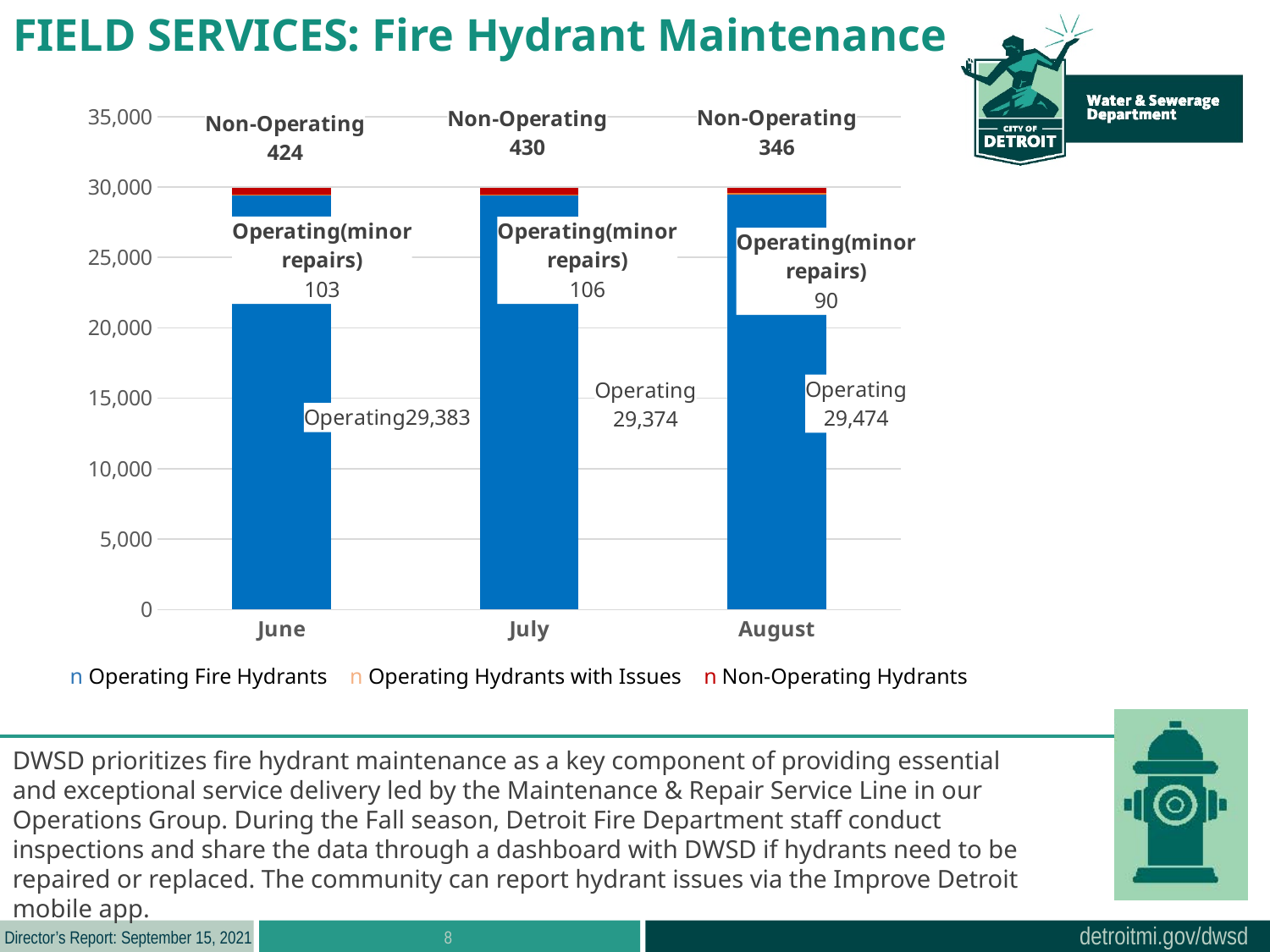
How many series does the chart legend list? 3 Which is larger, the Operating hydrant count in June or in August? August What is the number of Operating fire hydrants in June? 29,383 Which month has the lowest number of Operating (minor repairs) hydrants? August Which legend entry is shown in red? Non-Operating Hydrants What is the number of Operating (minor repairs) hydrants in August? 90 How many months are shown on the x axis of the chart? 3 Which month has the highest number of Non-Operating hydrants? July What is the number of Non-Operating hydrants in July? 430 What is the total number of hydrants in the June stacked bar? 29,910 What is the difference between the Non-Operating hydrant counts in July and August? 84 What kind of chart is shown on the slide? Stacked bar chart